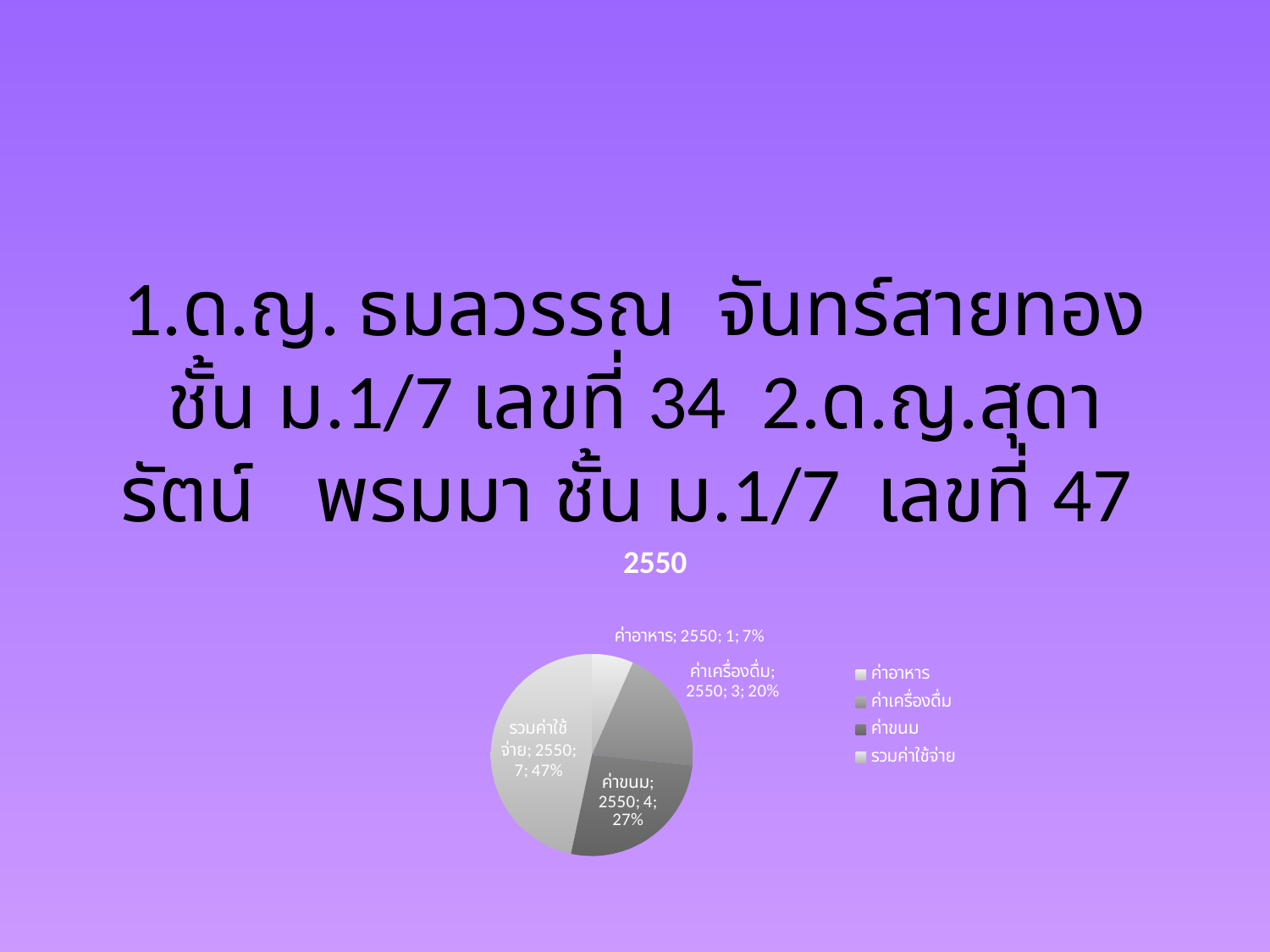
What is the value for ค่าอาหาร in the pie chart? 1 Which slice of the pie chart is the smallest? ค่าอาหาร Which slice of the pie chart is the largest? รวมค่าใช้จ่าย What is the difference between the values for ค่าขนม and ค่าเครื่องดื่ม? 1 What share of the pie does รวมค่าใช้จ่าย represent? 47% What is the value for รวมค่าใช้จ่าย in the pie chart? 7 What is the title of the chart? 2550 How many entries does the chart legend list? 4 What kind of chart is shown on the slide? pie chart How many slices does the pie chart have? 4 What is the value for ค่าขนม in the pie chart? 4 What share of the pie does ค่าเครื่องดื่ม represent? 20%